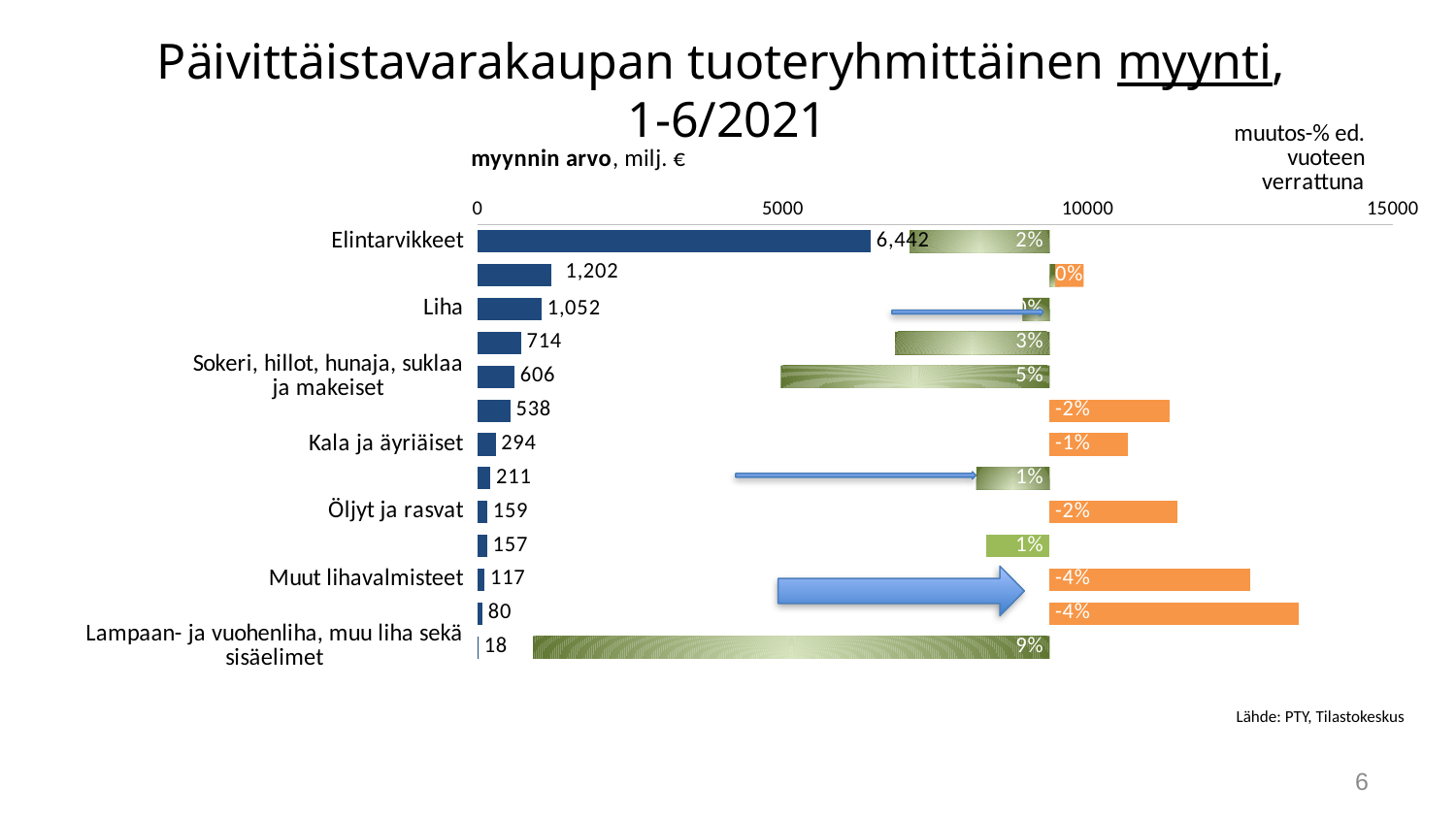
What is the sales value (myynnin arvo, milj. €) for Liha? 1,052 What is the change-% compared to the previous year for Muut lihavalmisteet? -4% What is the sales value (myynnin arvo, milj. €) for Kala ja äyriäiset? 294 How many bars are shown for sales value (myynnin arvo) in the chart? 13 Which has a larger sales value, Öljyt ja rasvat or Muut lihavalmisteet? Öljyt ja rasvat What is the sales value (myynnin arvo, milj. €) for Lampaan- ja vuohenliha, muu liha sekä sisäelimet? 18 Which category has the lowest sales value (myynnin arvo)? Lampaan- ja vuohenliha, muu liha sekä sisäelimet What is the sales value (myynnin arvo, milj. €) for Elintarvikkeet? 6,442 What is the difference in sales value between Liha and Kala ja äyriäiset? 758 What is the change-% compared to the previous year for Sokeri, hillot, hunaja, suklaa ja makeiset? 5% Which category has the highest sales value (myynnin arvo)? Elintarvikkeet What is the change-% compared to the previous year (muutos-% ed. vuoteen verrattuna) for Lampaan- ja vuohenliha, muu liha sekä sisäelimet? 9%